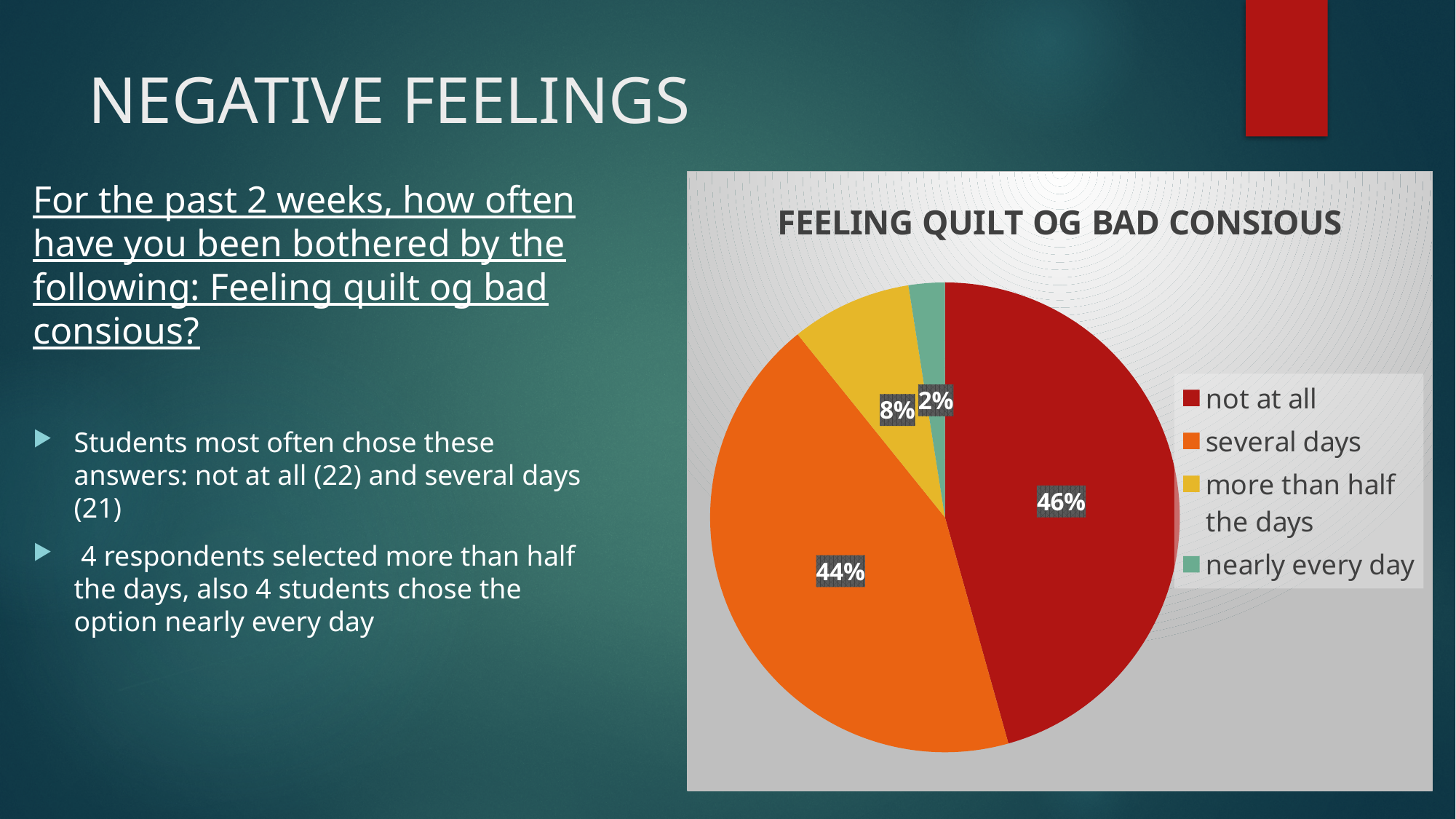
What share of the pie is labelled for 'nearly every day'? 2% What share of the pie is labelled for 'not at all'? 46% Which category has the smallest slice of the pie? nearly every day Which category has the largest slice of the pie? not at all What colour is the slice for 'several days'? orange What is the title of the chart? FEELING QUILT OG BAD CONSIOUS What kind of chart is shown on the slide? pie chart What share of the pie is labelled for 'more than half the days'? 8% What is the difference in percentage points between 'not at all' and 'several days'? 2% How many categories does the pie chart show? 4 Which is larger, the slice for 'more than half the days' or the slice for 'nearly every day'? more than half the days